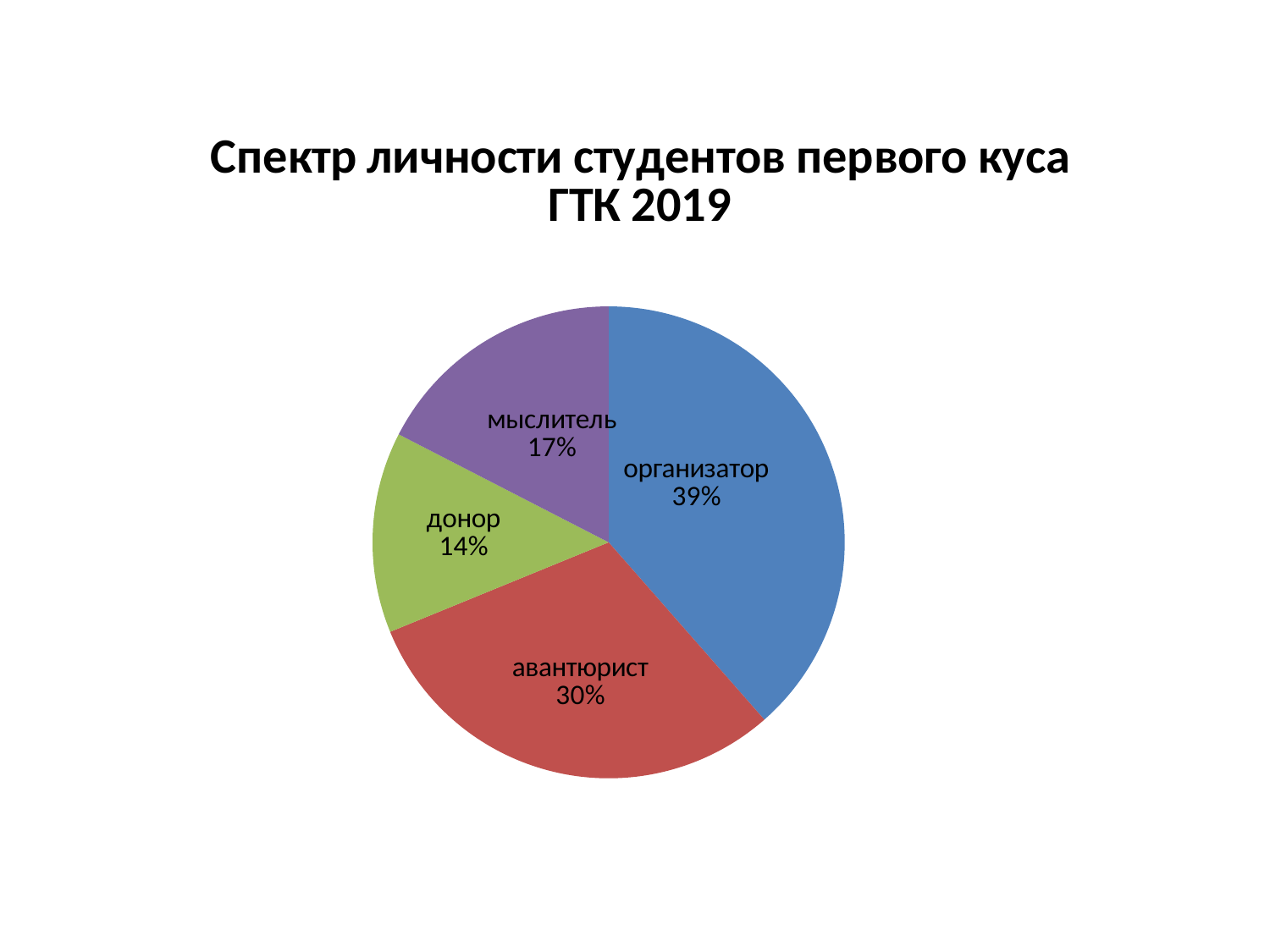
What is the difference in percentage points between организатор and авантюрист? 9 What share of the pie does мыслитель have? 17% Which category has the smallest slice of the pie? донор What is the title of the chart? Спектр личности студентов первого куса ГТК 2019 What share of the pie does авантюрист have? 30% What share of the pie does донор have? 14% What colour is the slice for авантюрист? red Which is larger, the share for мыслитель or the share for донор? мыслитель Which category has the largest slice of the pie? организатор What kind of chart is shown on the slide? pie chart How many slices does the pie chart have? 4